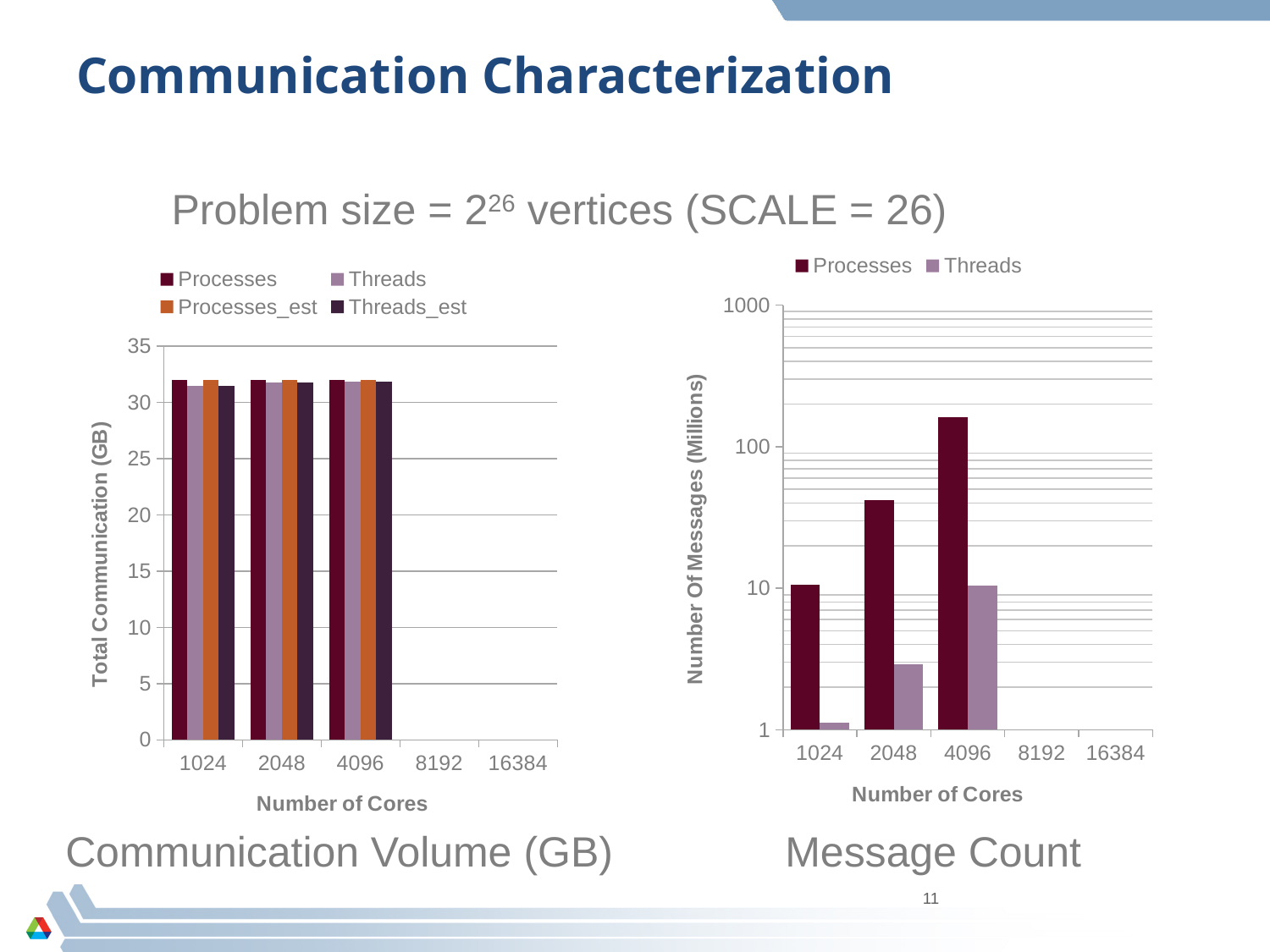
In the Message Count chart, is the Threads value at 2048 cores greater or less than 10? less How many series does the legend of the Message Count chart list? 2 In the Communication Volume (GB) chart, is the Processes value at 1024 cores greater or less than 30? greater In the Message Count chart, do the Processes values rise or fall from 1024 to 4096 cores? rise How many series does the legend of the Communication Volume (GB) chart list? 4 What type of chart is the Communication Volume (GB) chart on the left? bar chart What is the y-axis title of the Message Count chart? Number Of Messages (Millions) In the Message Count chart, is the Processes value at 4096 cores greater or less than 100? greater In the Message Count chart, at 4096 cores, which is larger: Processes or Threads? Processes How many core counts are labelled on the x axis of the Message Count chart? 5 In the Message Count chart, which core count has the highest Processes value? 4096